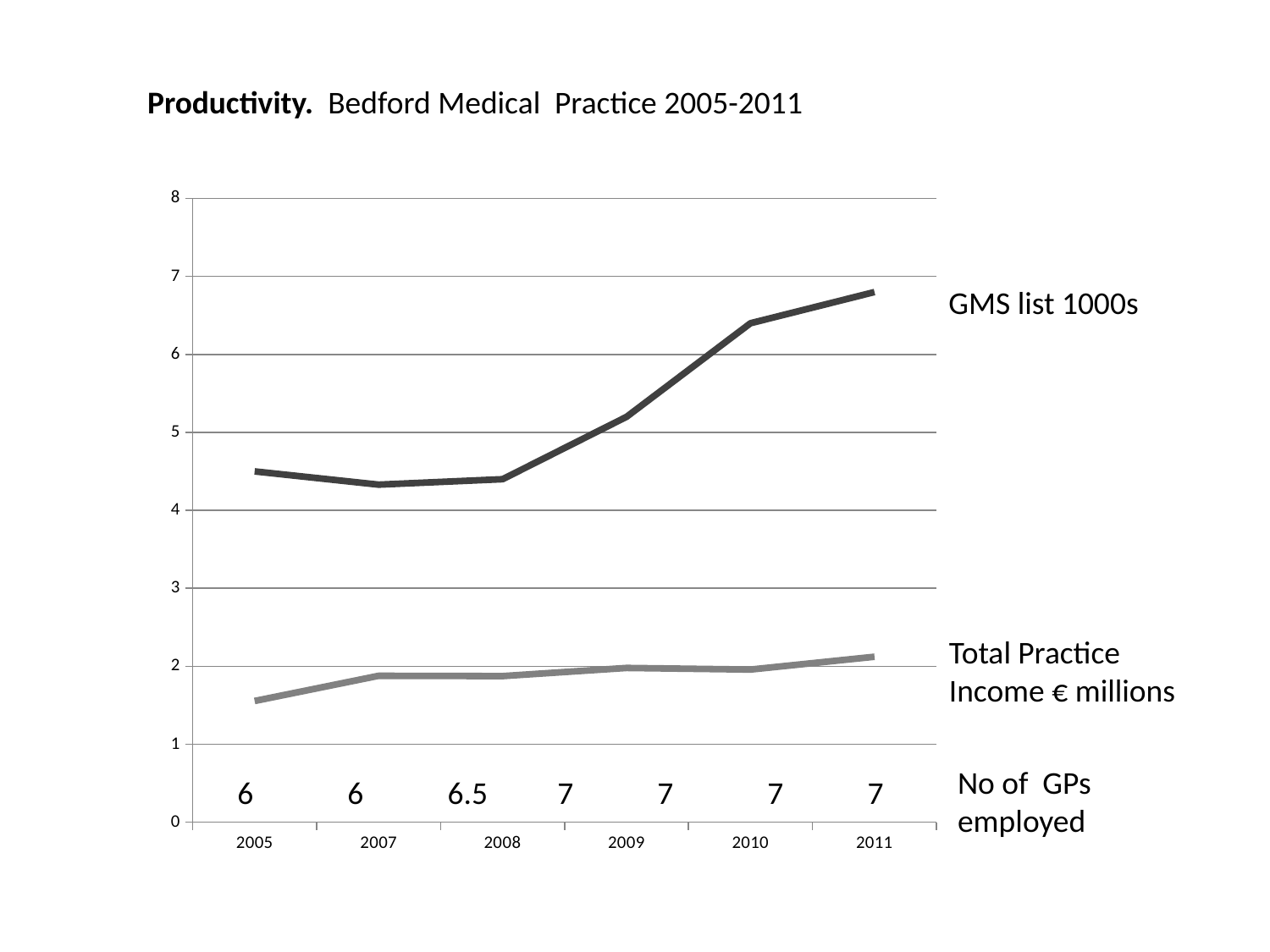
Is the value for GMS list 1000s in 2011 greater or less than 6? greater Is the value for Total Practice Income € millions in 2005 greater or less than 2? less What is the title of the chart? Productivity. Bedford Medical Practice 2005-2011 What kind of chart is shown on the slide? line chart How many data series are plotted as lines on the chart? 2 Does the GMS list 1000s line rise or fall overall from 2005 to 2011? rise How many years are plotted along the x axis of the chart? 6 Which series is drawn as the darker, upper line on the chart? GMS list 1000s Is the value for GMS list 1000s in 2010 greater or less than 6? greater In which year is the GMS list 1000s value highest? 2011 In which year is the Total Practice Income € millions value lowest? 2005